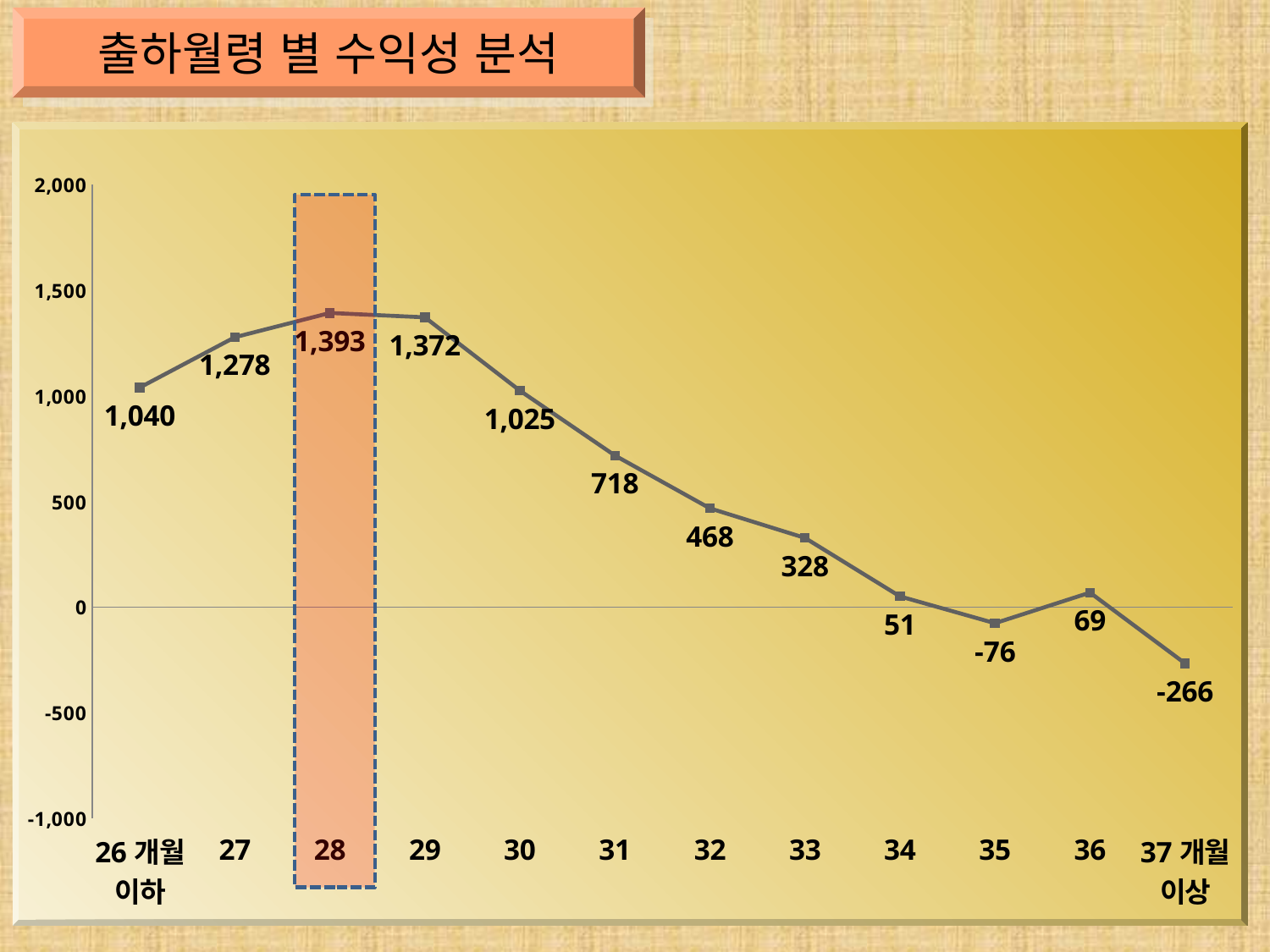
What kind of chart is shown on the slide? Line chart What is the value for 28 months? 1,393 What is the difference between the values for 30 and 31 months? 307 What is the value for 26 개월 이하? 1,040 What is the value for 35 months? -76 How many data points are plotted on the chart? 12 Which category has the lowest value? 37 개월 이상 Which is larger, the value for 27 months or the value for 30 months? 27 What is the difference between the values for 28 and 29 months? 21 What is the title of the slide? 출하월령 별 수익성 분석 What is the value for 37 개월 이상? -266 Which category has the highest value? 28